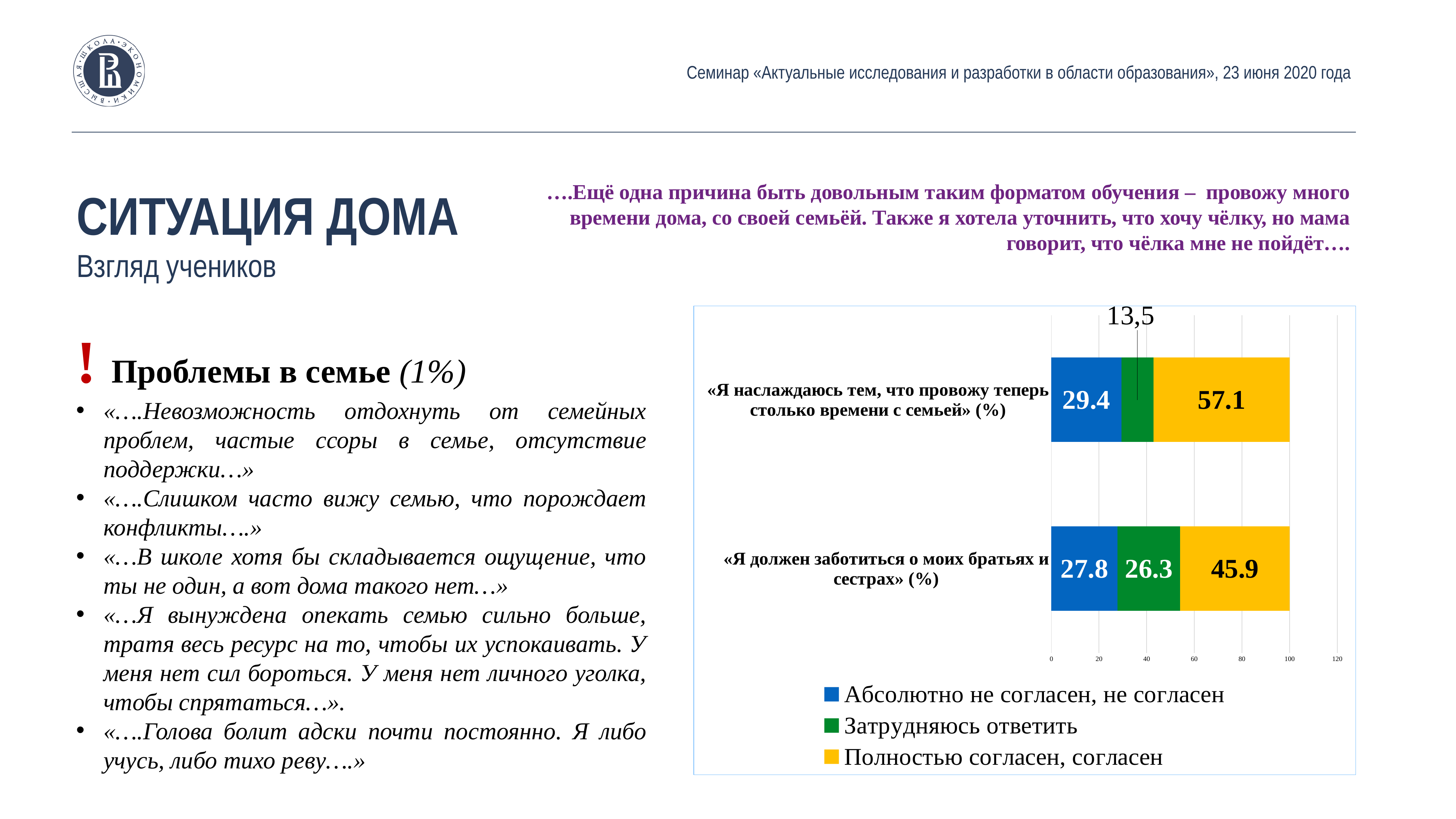
How many series does the chart legend list? 3 What is the total of the stacked bar for «Я должен заботиться о моих братьях и сестрах»? 100 What is the value of «Абсолютно не согласен, не согласен» for the statement «Я должен заботиться о моих братьях и сестрах»? 27.8 What is the value of «Затрудняюсь ответить» for the statement «Я наслаждаюсь тем, что провожу теперь столько времени с семьей»? 13,5 Which statement has the higher value for «Полностью согласен, согласен»? «Я наслаждаюсь тем, что провожу теперь столько времени с семьей» How many categories (statements) are plotted in the chart? 2 What is the value of «Затрудняюсь ответить» for the statement «Я должен заботиться о моих братьях и сестрах»? 26.3 What kind of chart is shown on the slide? Stacked bar chart What is the difference between the «Полностью согласен, согласен» values for the two statements (57.1 and 45.9)? 11.2 What is the value of «Полностью согласен, согласен» for the statement «Я наслаждаюсь тем, что провожу теперь столько времени с семьей»? 57.1 Which is larger: «Абсолютно не согласен, не согласен» for «Я наслаждаюсь тем, что провожу теперь столько времени с семьей» or for «Я должен заботиться о моих братьях и сестрах»? «Я наслаждаюсь тем, что провожу теперь столько времени с семьей» (29.4) Which colour represents «Затрудняюсь ответить» in the chart? Green